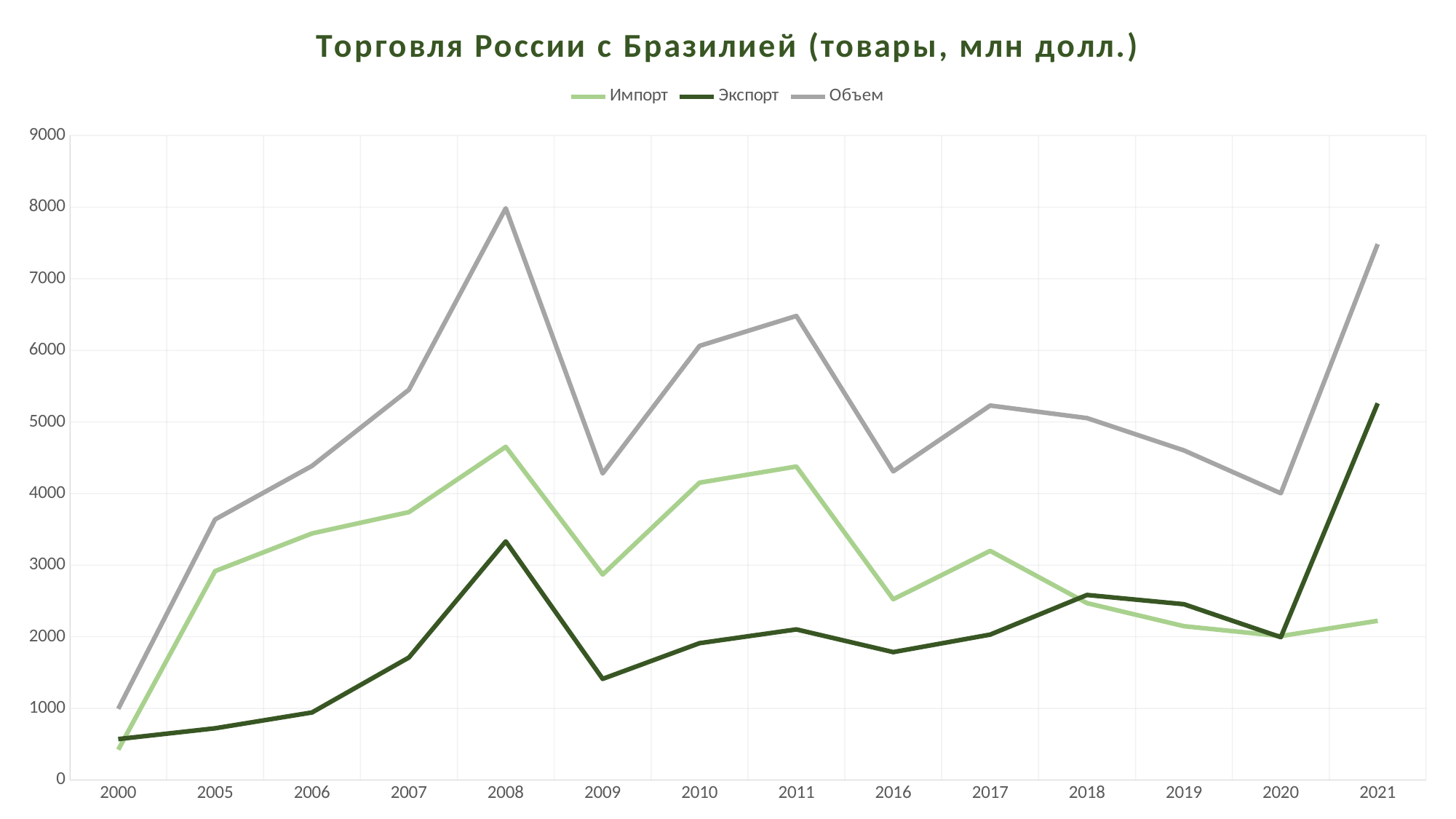
How many series does the legend list? 3 In which year is the Объем series at its lowest value? 2000 Is the value of Объем in 2020 greater or less than 5000? less In which year does the Объем series reach its highest value? 2008 Which is larger in 2021, Экспорт or Импорт? Экспорт In which year does the Экспорт series reach its highest value? 2021 Is the value of Объем in 2008 greater or less than 7000? greater Does the Экспорт series rise or fall from 2020 to 2021? rise How many years are shown on the x axis? 14 What is the title of the chart? Торговля России с Бразилией (товары, млн долл.) What kind of chart is shown on the slide? line chart Is the value of Импорт in 2016 greater or less than 3000? less